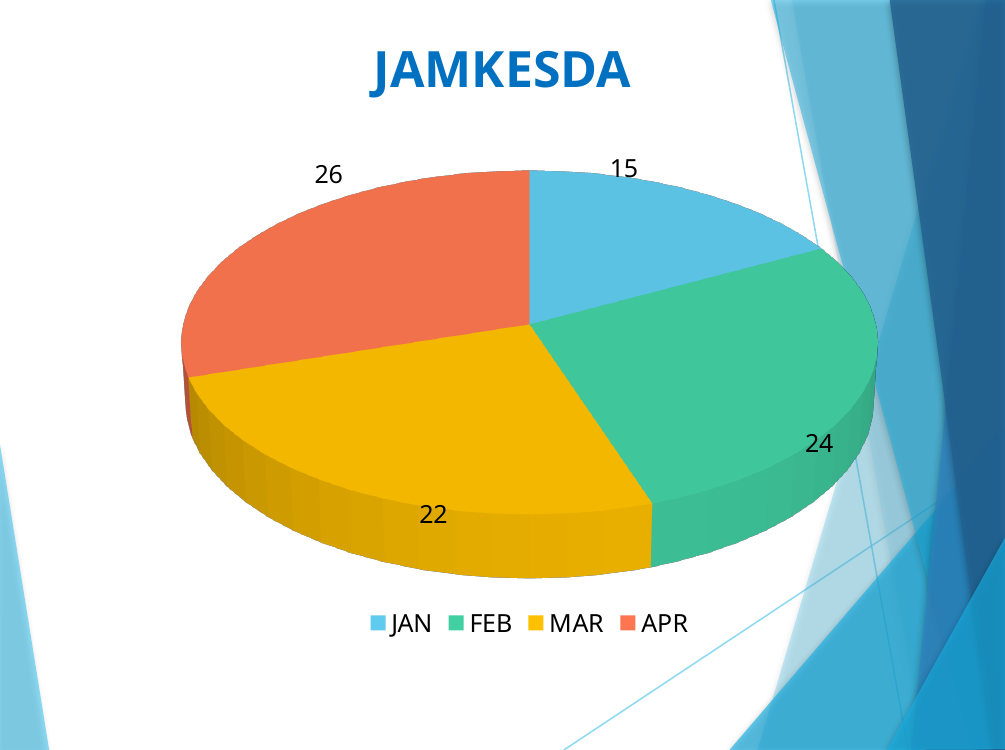
What type of chart is shown on the slide? Pie chart How many slices does the JAMKESDA pie chart have? 4 Which month has the largest slice in the JAMKESDA pie chart? APR Which is larger, the value for FEB or the value for JAN? FEB What is the value for JAN in the JAMKESDA pie chart? 15 What is the title of the chart on the slide? JAMKESDA What is the value for MAR in the JAMKESDA pie chart? 22 What is the value for FEB in the JAMKESDA pie chart? 24 What is the difference between the values for APR and JAN? 11 What is the difference between the values for FEB and MAR? 2 What is the value for APR in the JAMKESDA pie chart? 26 Which month has the smallest slice in the JAMKESDA pie chart? JAN